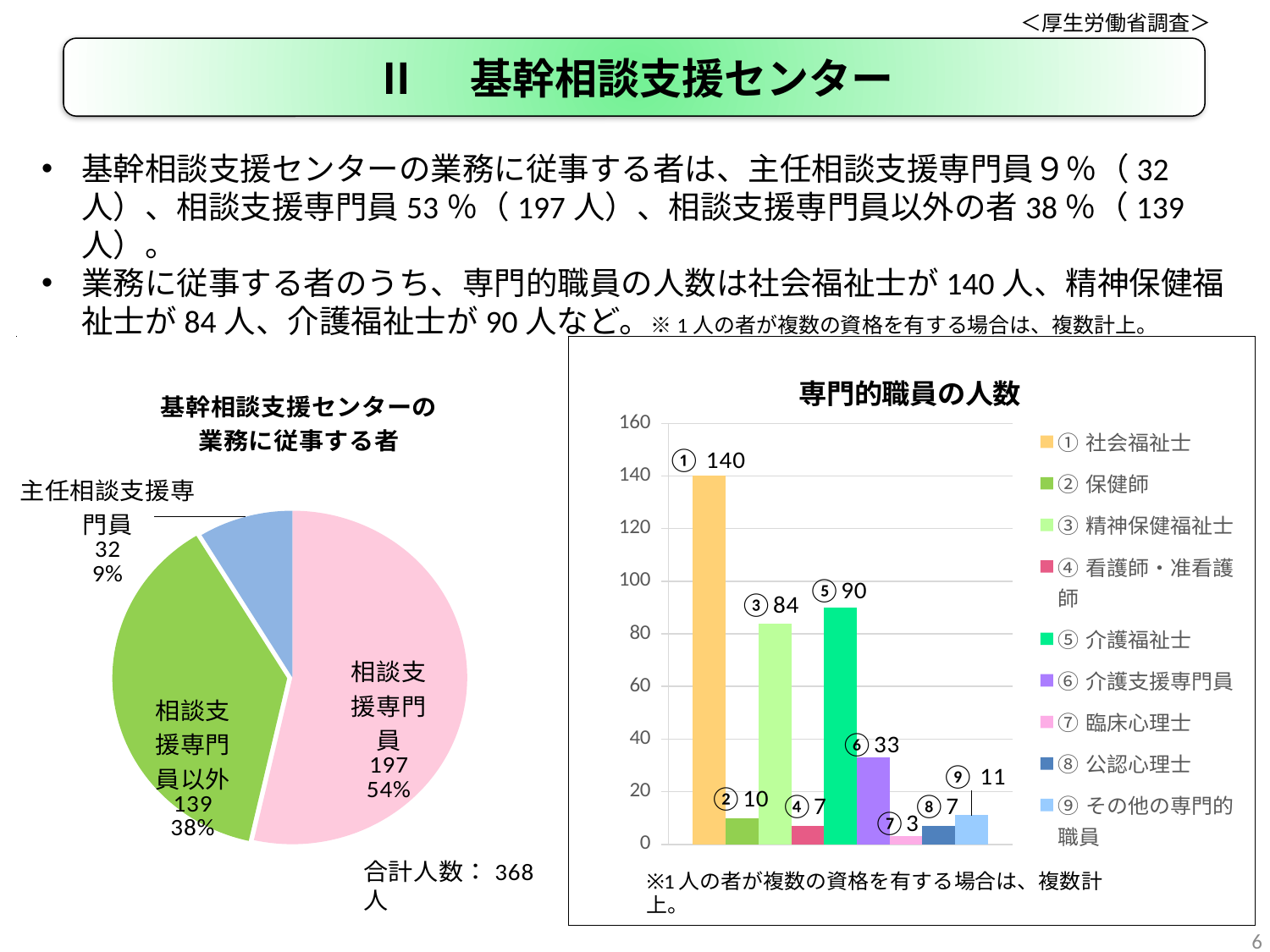
「基幹相談支援センターの業務に従事する者」のグラフで、相談支援専門員の割合は何%ですか。 54% 「専門的職員の人数」のグラフで、②保健師と⑨その他の専門的職員では、どちらの人数が多いですか。 ⑨その他の専門的職員 「専門的職員の人数」のグラフの凡例には、いくつの職種が示されていますか。 9 「専門的職員の人数」のグラフで、最も人数が少ない職種はどれですか。 ⑦臨床心理士 「基幹相談支援センターの業務に従事する者」のグラフは、どの種類のグラフですか。 円グラフ 「専門的職員の人数」のグラフで、①社会福祉士の人数はいくつですか。 140 「専門的職員の人数」のグラフで、⑥介護支援専門員の人数はいくつですか。 33 「基幹相談支援センターの業務に従事する者」のグラフで、主任相談支援専門員の人数はいくつですか。 32 「専門的職員の人数」のグラフで、⑤介護福祉士と③精神保健福祉士の人数の差はいくつですか。 6 「専門的職員の人数」のグラフで、最も人数が多い職種はどれですか。 ①社会福祉士 「専門的職員の人数」のグラフは、どの種類のグラフですか。 棒グラフ 「基幹相談支援センターの業務に従事する者」のグラフで、最も割合が小さい区分はどれですか。 主任相談支援専門員